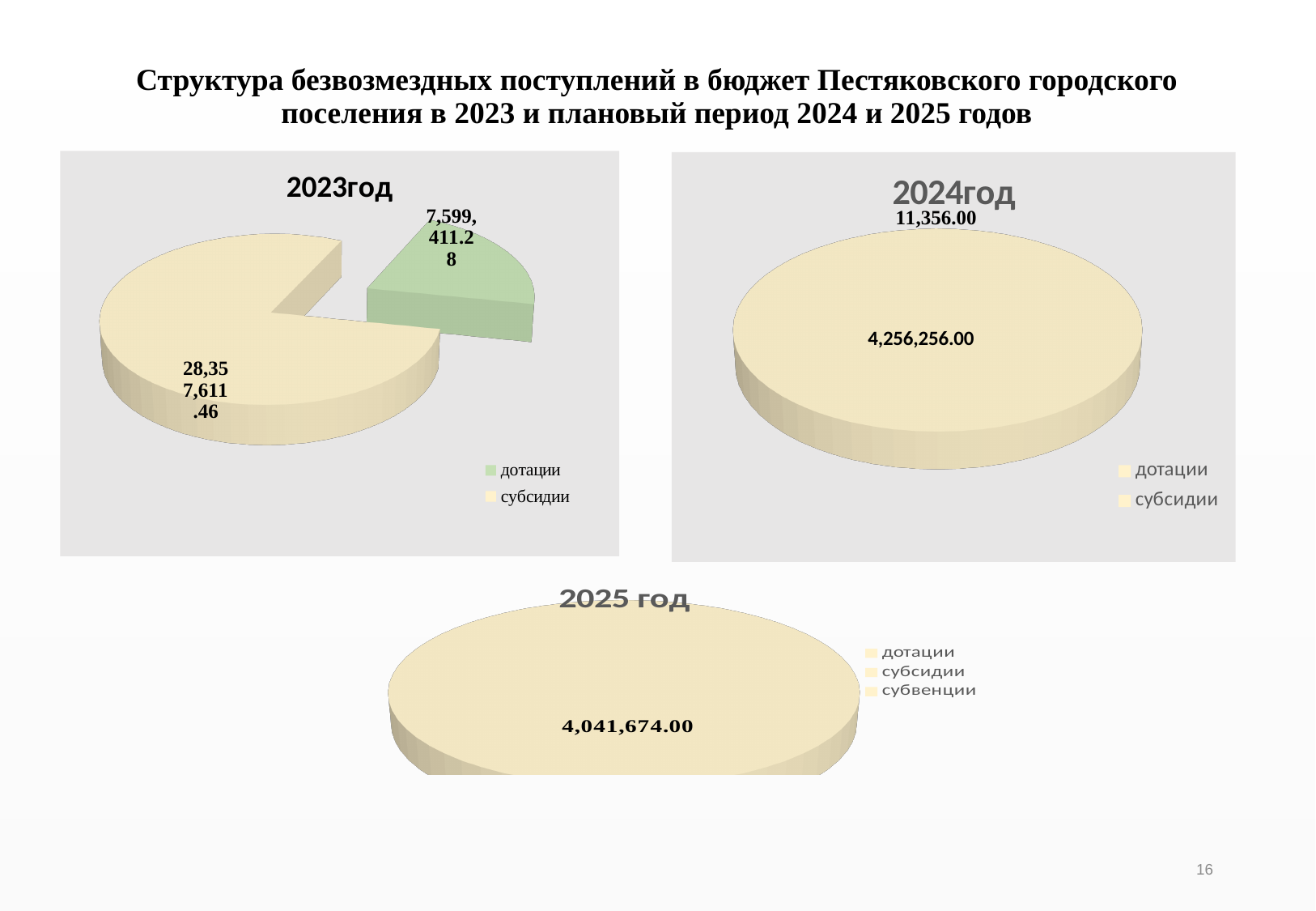
What kind of chart is the 2024год chart? pie chart On the 2023год chart, what is the value for субсидии? 28,357,611.46 On the 2025 год chart, how many entries does the legend list? 3 On the 2025 год chart, what value is printed on the pie? 4,041,674.00 On the 2023год chart, how many entries does the legend list? 2 On the 2024год chart, what is the largest value printed on the pie? 4,256,256.00 On the 2023год chart, which category has the smallest slice? дотации On the 2023год chart, which is larger, дотации or субсидии? субсидии On the 2023год chart, what is the difference between субсидии and дотации? 20,758,200.18 On the 2023год chart, which category has the largest slice? субсидии On the 2023год chart, what is the value for дотации? 7,599,411.28 On the 2024год chart, what is the smallest value printed on the pie? 11,356.00